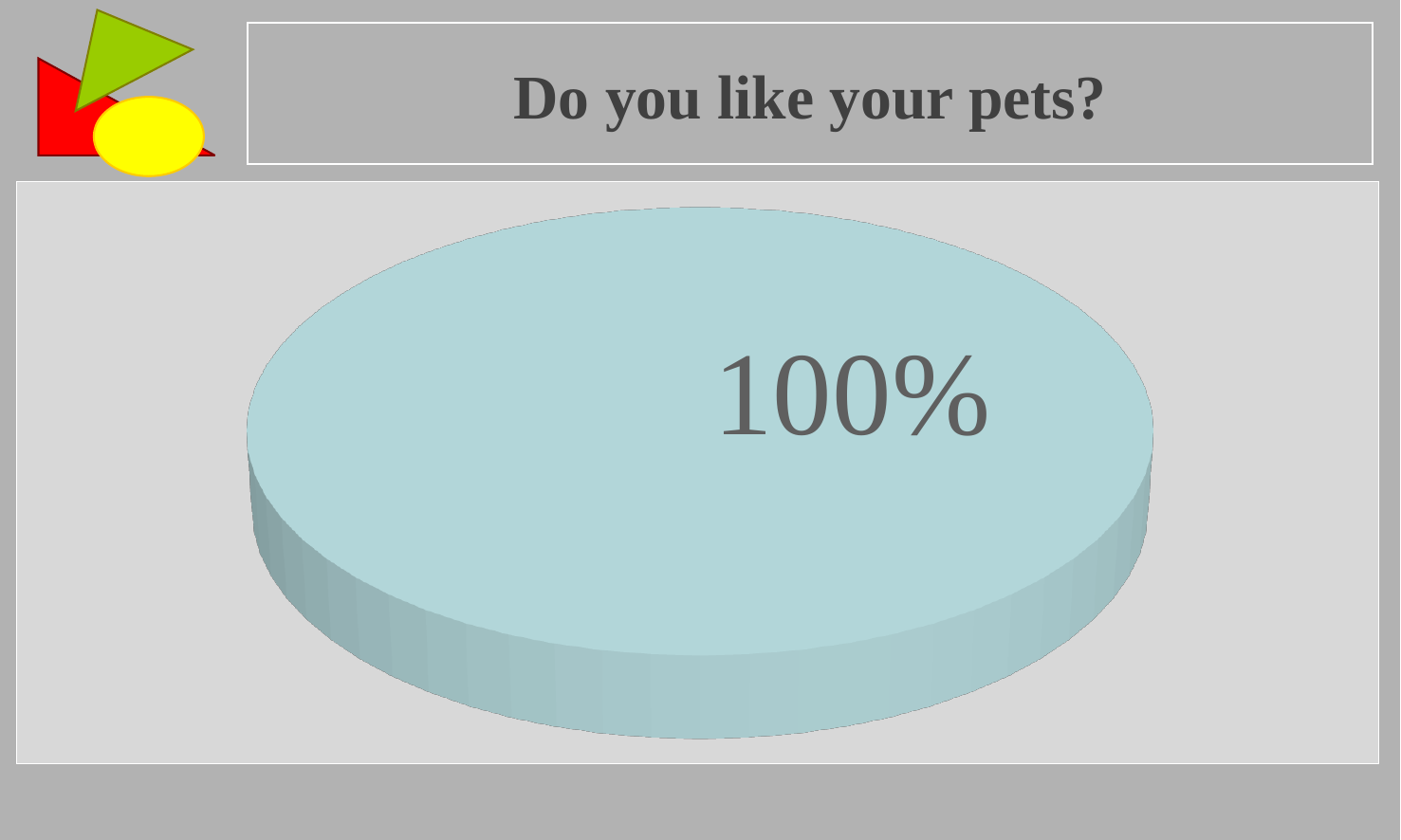
What kind of chart is shown on the slide? pie chart Is the share shown on the pie chart greater or less than 50%? greater What colour is the single slice of the pie chart? light blue What is the title shown above the pie chart? Do you like your pets? How many slices does the pie chart have? 1 What percentage is printed on the pie chart's slice? 100%